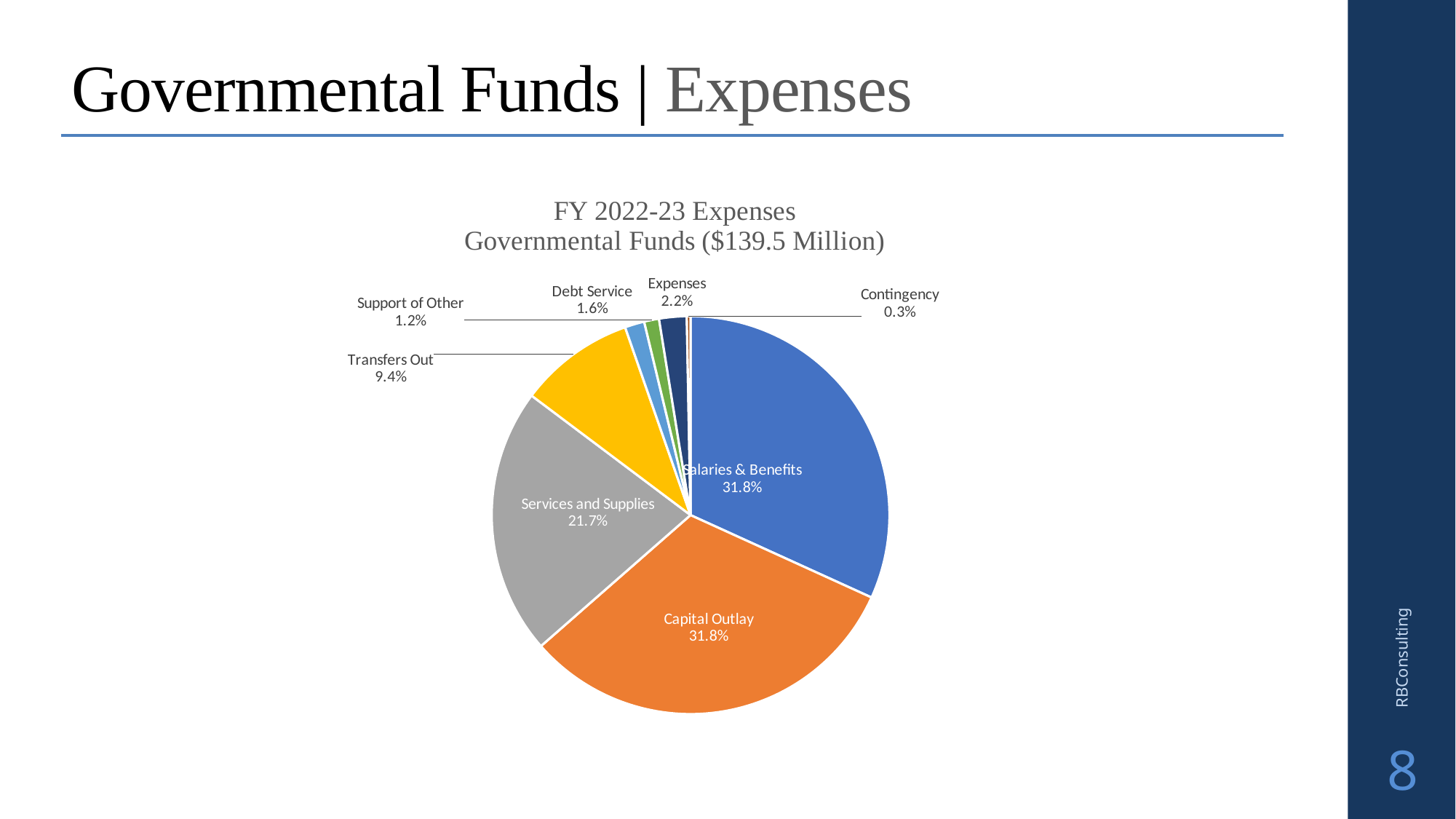
What is the title of the chart? FY 2022-23 Expenses Governmental Funds ($139.5 Million) Which is larger, Expenses or Debt Service? Expenses What is the combined share of Salaries & Benefits and Capital Outlay? 63.6% What percentage is shown for Debt Service? 1.6% What percentage is shown for Support of Other? 1.2% What type of chart is shown on the slide? pie chart Which category has the smallest slice of the pie? Contingency What share of the pie is Services and Supplies? 21.7% What percentage is shown for Capital Outlay? 31.8% What is the difference in percentage points between Services and Supplies and Transfers Out? 12.3 How many slices does the pie chart have? 8 What share of the pie is Transfers Out? 9.4%